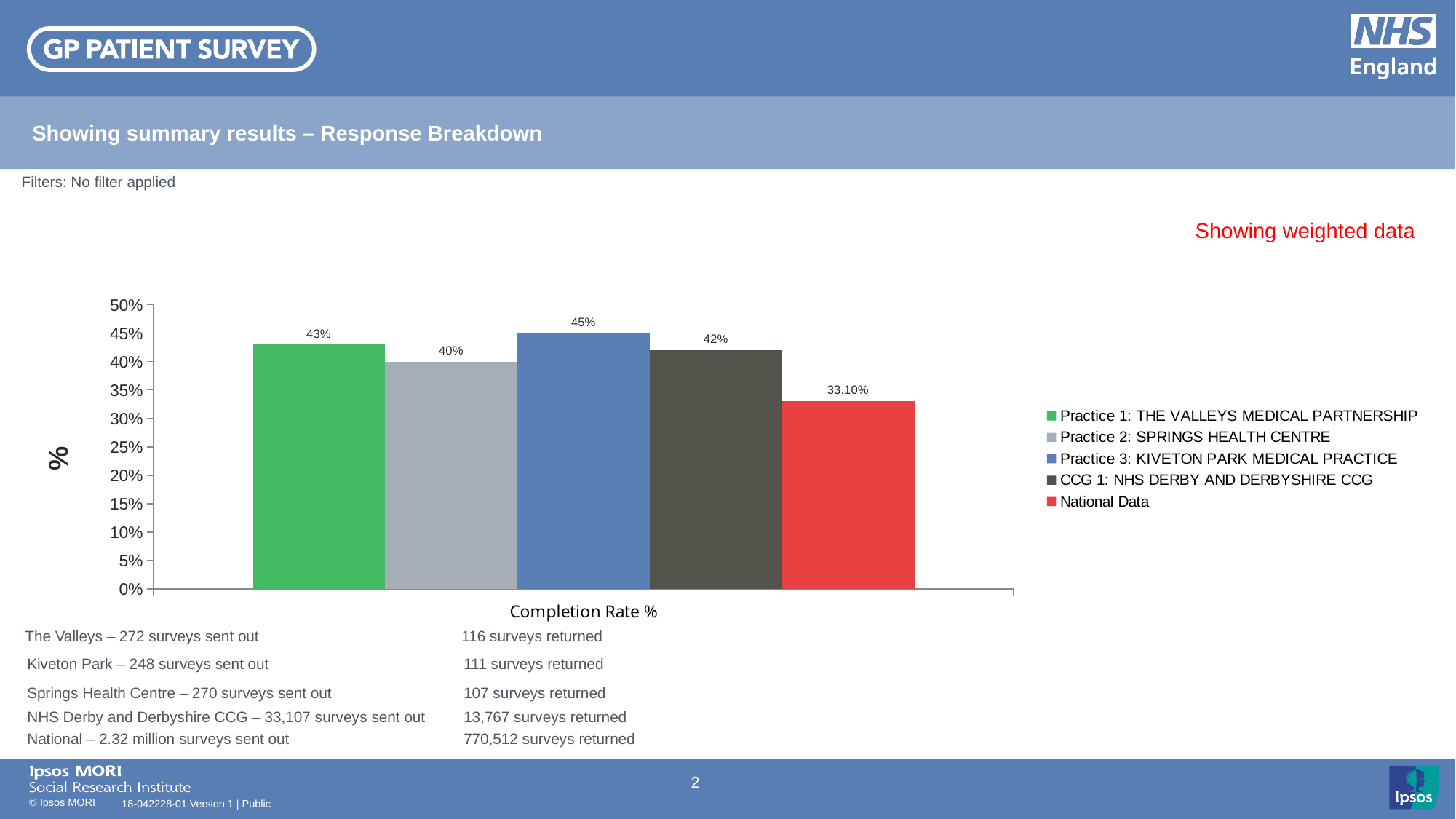
What kind of chart is shown on the slide? Bar chart What is the completion rate for Practice 3: KIVETON PARK MEDICAL PRACTICE? 45% What is the completion rate for National Data? 33.10% What is the completion rate for Practice 1: THE VALLEYS MEDICAL PARTNERSHIP? 43% Which series has the highest completion rate? Practice 3: KIVETON PARK MEDICAL PRACTICE What is the label on the x axis of the chart? Completion Rate % Which series has the lowest completion rate? National Data Which has a higher completion rate, Practice 1: THE VALLEYS MEDICAL PARTNERSHIP or CCG 1: NHS DERBY AND DERBYSHIRE CCG? Practice 1: THE VALLEYS MEDICAL PARTNERSHIP What is the difference in completion rate between Practice 3: KIVETON PARK MEDICAL PRACTICE and Practice 2: SPRINGS HEALTH CENTRE? 5% How many series does the legend list? 5 What is the completion rate for Practice 2: SPRINGS HEALTH CENTRE? 40% What is the completion rate for CCG 1: NHS DERBY AND DERBYSHIRE CCG? 42%